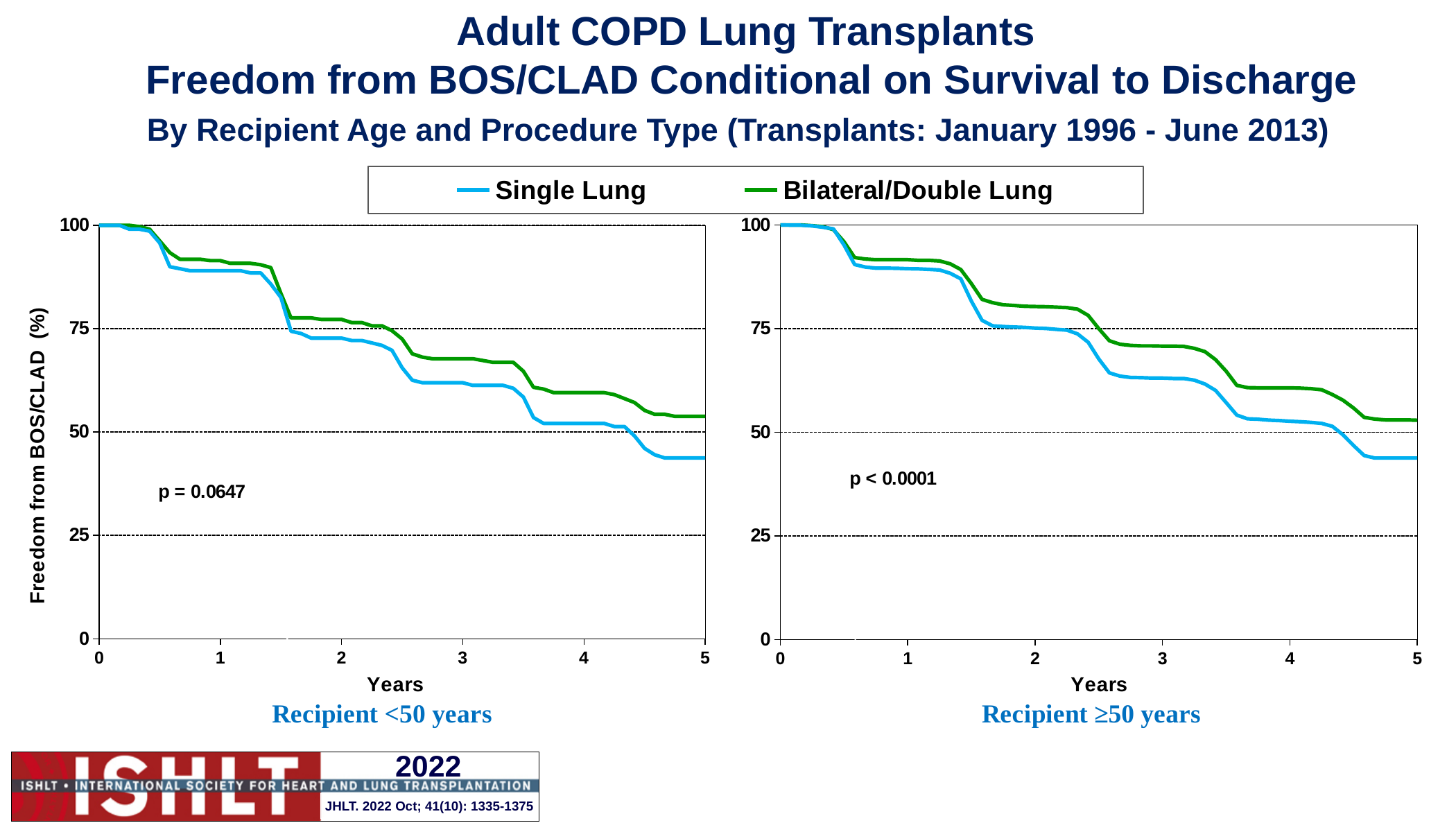
In the Recipient ≥50 years chart, is the Bilateral/Double Lung value at 3 years greater or less than 75? less In the Recipient ≥50 years chart, at 5 years, which series is higher: Single Lung or Bilateral/Double Lung? Bilateral/Double Lung What p-value is printed on the Recipient <50 years chart? p = 0.0647 In the Recipient <50 years chart, is the Single Lung value at 1 year greater or less than 75? greater In the Recipient <50 years chart, is the Bilateral/Double Lung value at 5 years greater or less than 50? greater How many series does the legend list? 2 In the Recipient <50 years chart, at 5 years, which series is higher: Single Lung or Bilateral/Double Lung? Bilateral/Double Lung What kind of chart is shown in the left panel (Recipient <50 years)? line chart What p-value is printed on the Recipient ≥50 years chart? p < 0.0001 In the Recipient <50 years chart, do the values rise or fall as years increase? fall